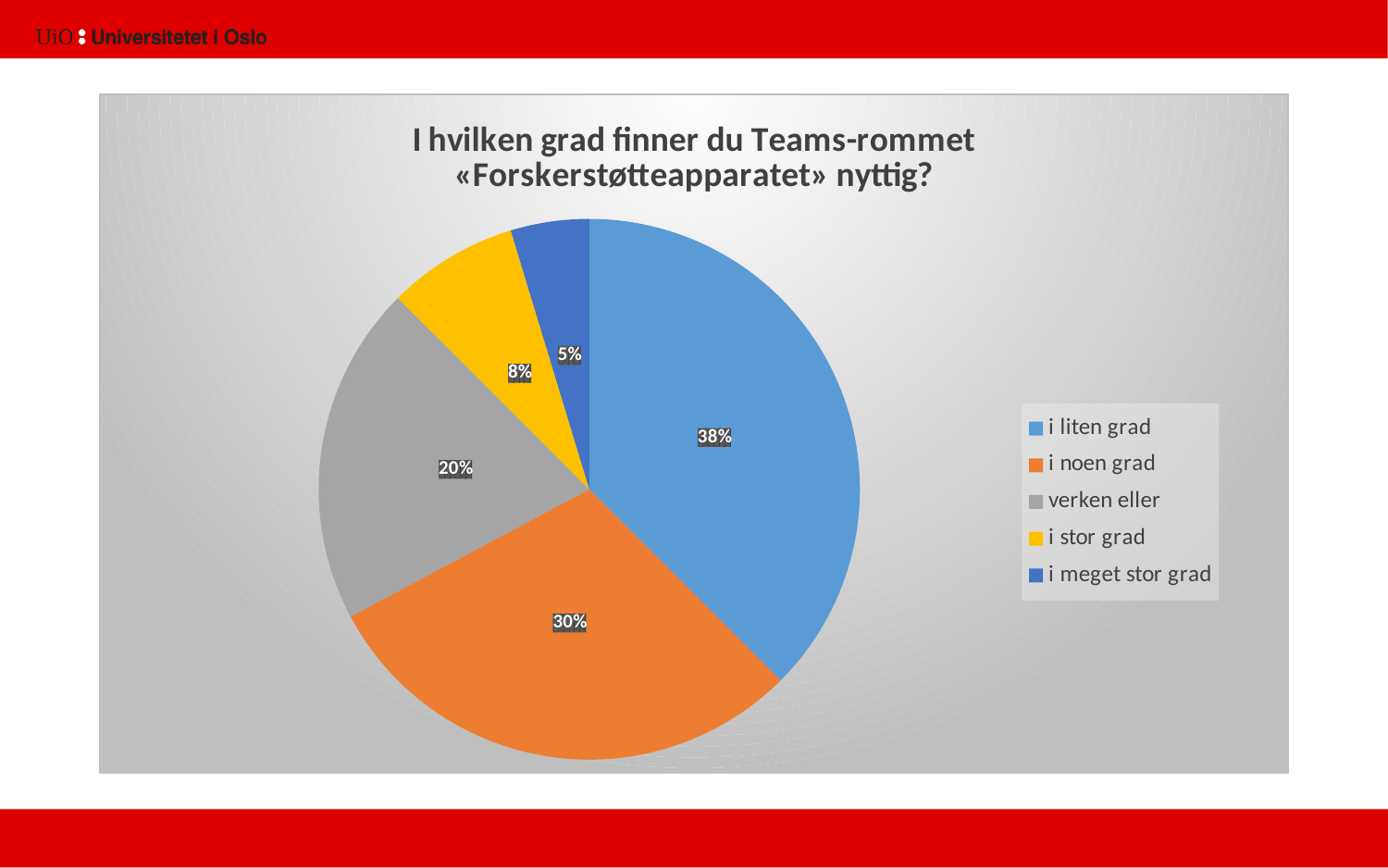
What kind of chart is shown on the slide? pie chart What share of the pie is labelled "i meget stor grad"? 5% Which category has the smallest slice of the pie? i meget stor grad Which category has the largest slice of the pie? i liten grad What is the difference in percentage points between "i liten grad" and "i noen grad"? 8 What share of the pie is labelled "i stor grad"? 8% What colour is the slice for "i stor grad"? yellow How many categories does the legend list? 5 What share of the pie is labelled "verken eller"? 20% What share of the pie is labelled "i liten grad"? 38% What share of the pie is labelled "i noen grad"? 30% Which is larger, the slice for "verken eller" or the slice for "i stor grad"? verken eller